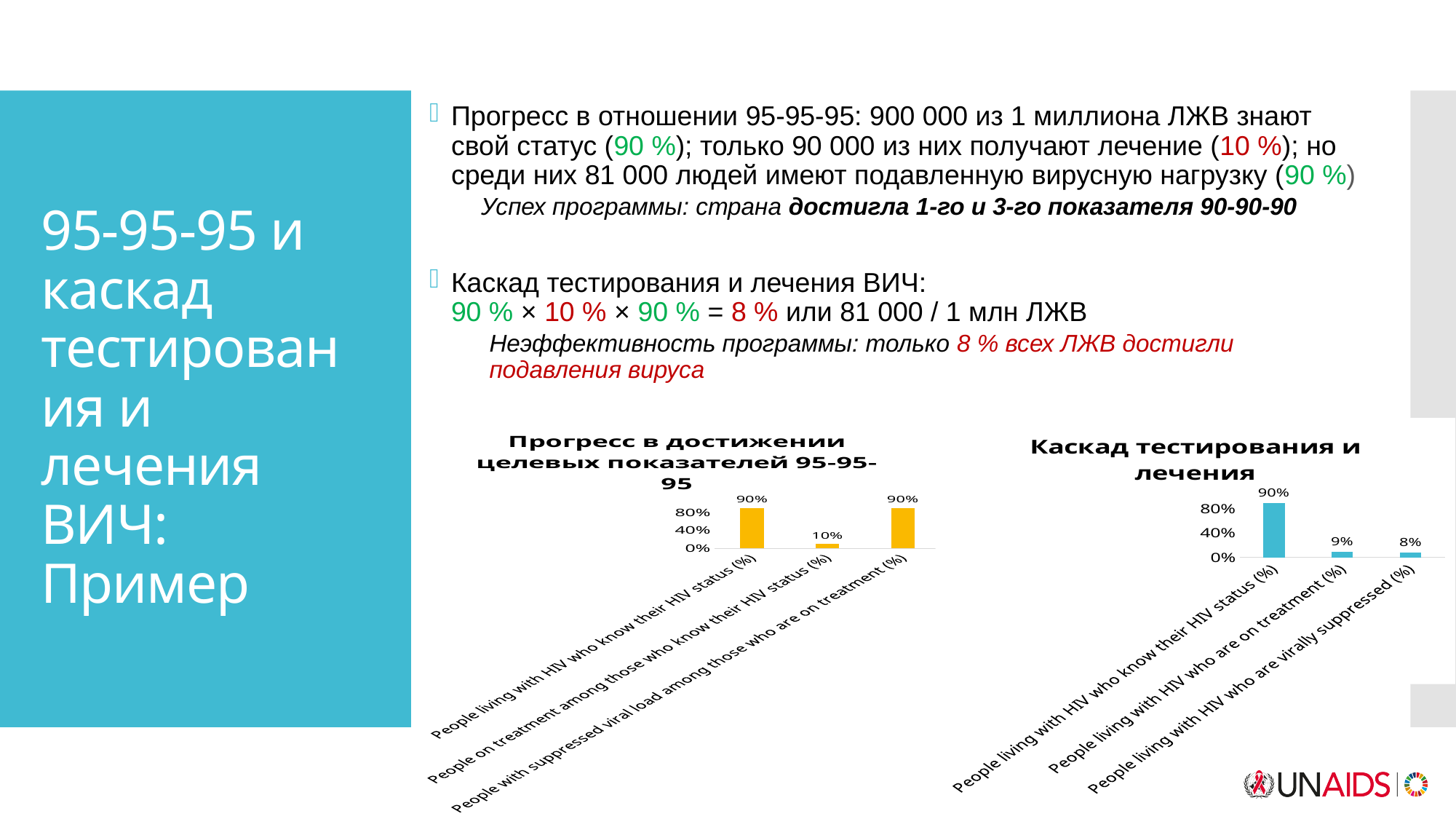
In the chart titled "Каскад тестирования и лечения", which category has the highest value? People living with HIV who know their HIV status (%) In the chart titled "Прогресс в достижении целевых показателей 95-95-95", what is the value for "People with suppressed viral load among those who are on treatment (%)"? 90% In the chart titled "Прогресс в достижении целевых показателей 95-95-95", how many bars are plotted? 3 What type of chart is the chart titled "Каскад тестирования и лечения"? bar chart In the chart titled "Каскад тестирования и лечения", what is the difference between "People living with HIV who know their HIV status (%)" and "People living with HIV who are virally suppressed (%)"? 82% In the chart titled "Каскад тестирования и лечения", what is the value for "People living with HIV who are on treatment (%)"? 9% In the chart titled "Каскад тестирования и лечения", what is the value for "People living with HIV who are virally suppressed (%)"? 8% In the chart titled "Каскад тестирования и лечения", do the values rise or fall from left to right? fall In the chart titled "Прогресс в достижении целевых показателей 95-95-95", which category has the lowest value? People on treatment among those who know their HIV status (%) What colour are the bars in the chart titled "Прогресс в достижении целевых показателей 95-95-95"? orange In the chart titled "Прогресс в достижении целевых показателей 95-95-95", what is the difference between the first bar and the second bar? 80% In the chart titled "Прогресс в достижении целевых показателей 95-95-95", what is the value for "People on treatment among those who know their HIV status (%)"? 10%